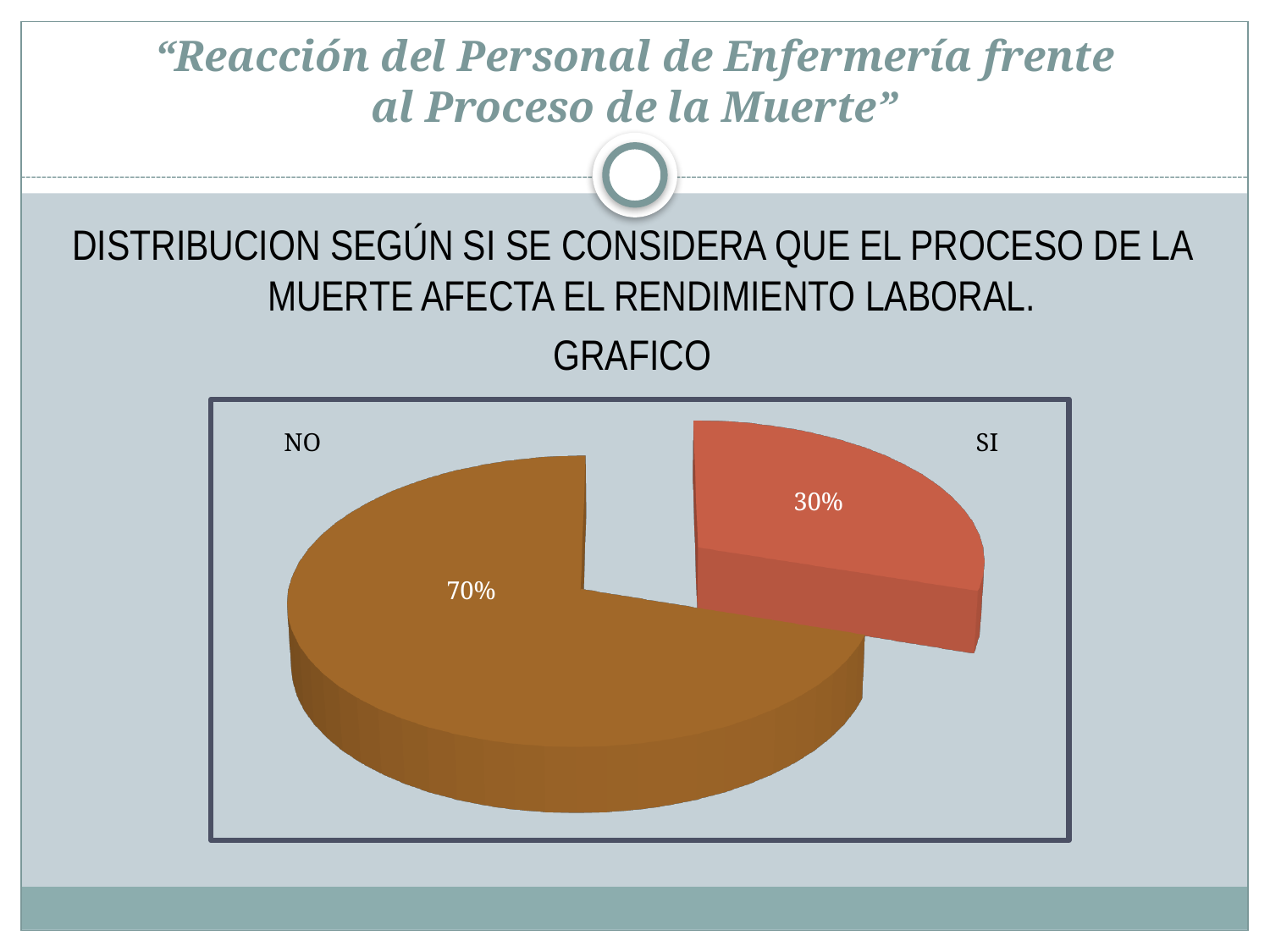
What share of the pie does the SI slice represent? 30% What percentage is shown for the SI slice? 30% How many slices does the pie chart have? 2 What percentage is shown for the NO slice? 70% Which slice is larger, NO or SI? NO Which category has the largest slice of the pie? NO What kind of chart is shown on the slide? Pie chart What colour is the NO slice of the pie? Brown What colour is the SI slice of the pie? Red Which category has the smallest slice of the pie? SI What is the difference in percentage points between the NO and SI slices? 40